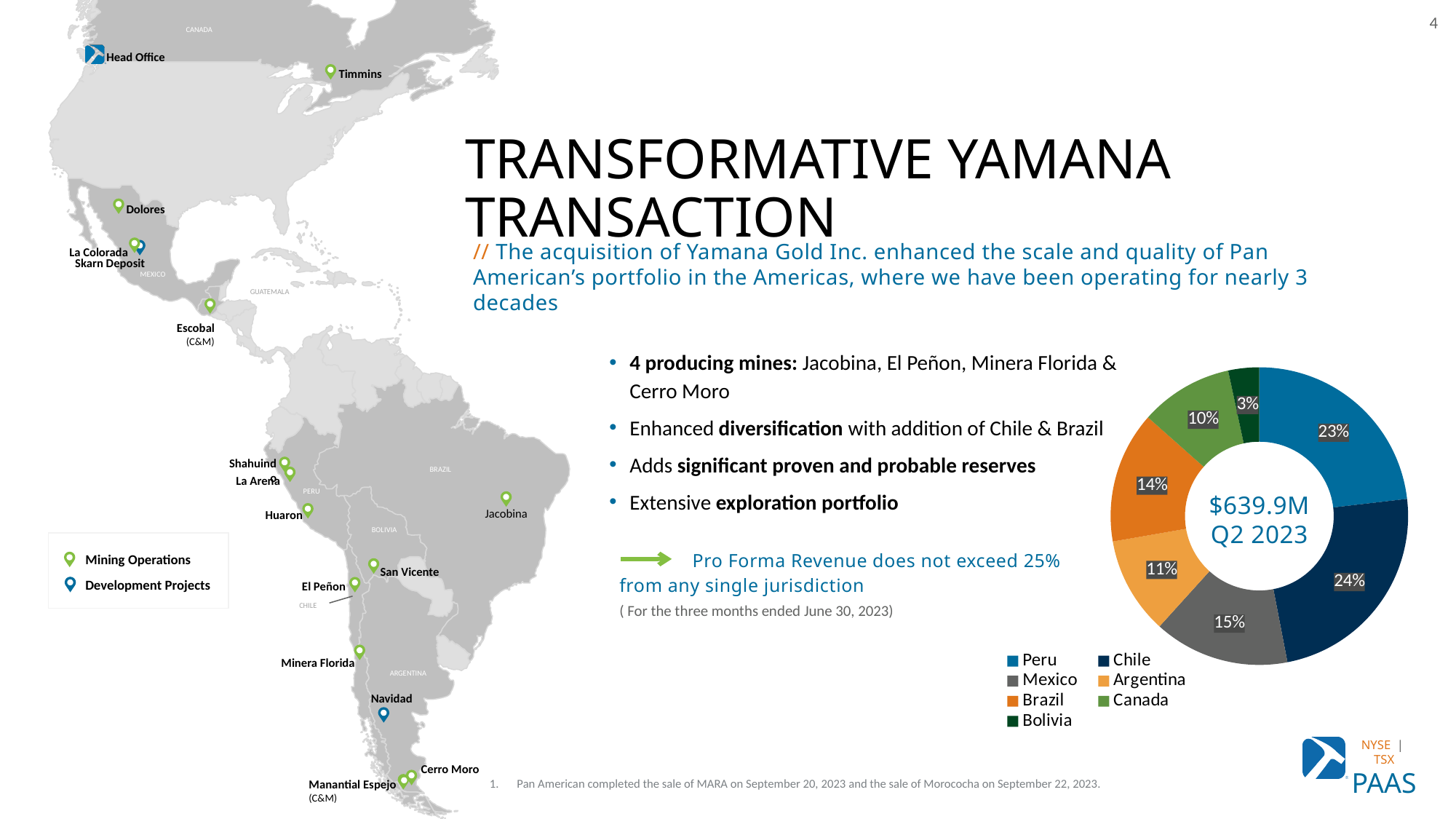
What kind of chart is shown on the slide? Pie chart (donut) How many jurisdictions are listed in the pie chart legend? 7 Which period does the donut chart cover, according to its centre label? Q2 2023 What total revenue figure is shown in the centre of the donut chart? $639.9M Which has a larger share in the pie chart, Mexico or Canada? Mexico Which jurisdiction has the smallest share in the pie chart? Bolivia What percentage is shown for Bolivia in the pie chart? 3% What percentage is shown for Mexico in the pie chart? 15% Which jurisdiction has the largest share in the pie chart? Chile What share of pro forma revenue does Chile account for in the pie chart? 24% What share of pro forma revenue does Peru account for in the pie chart? 23% What is the difference in percentage points between Brazil's and Argentina's shares in the pie chart? 3